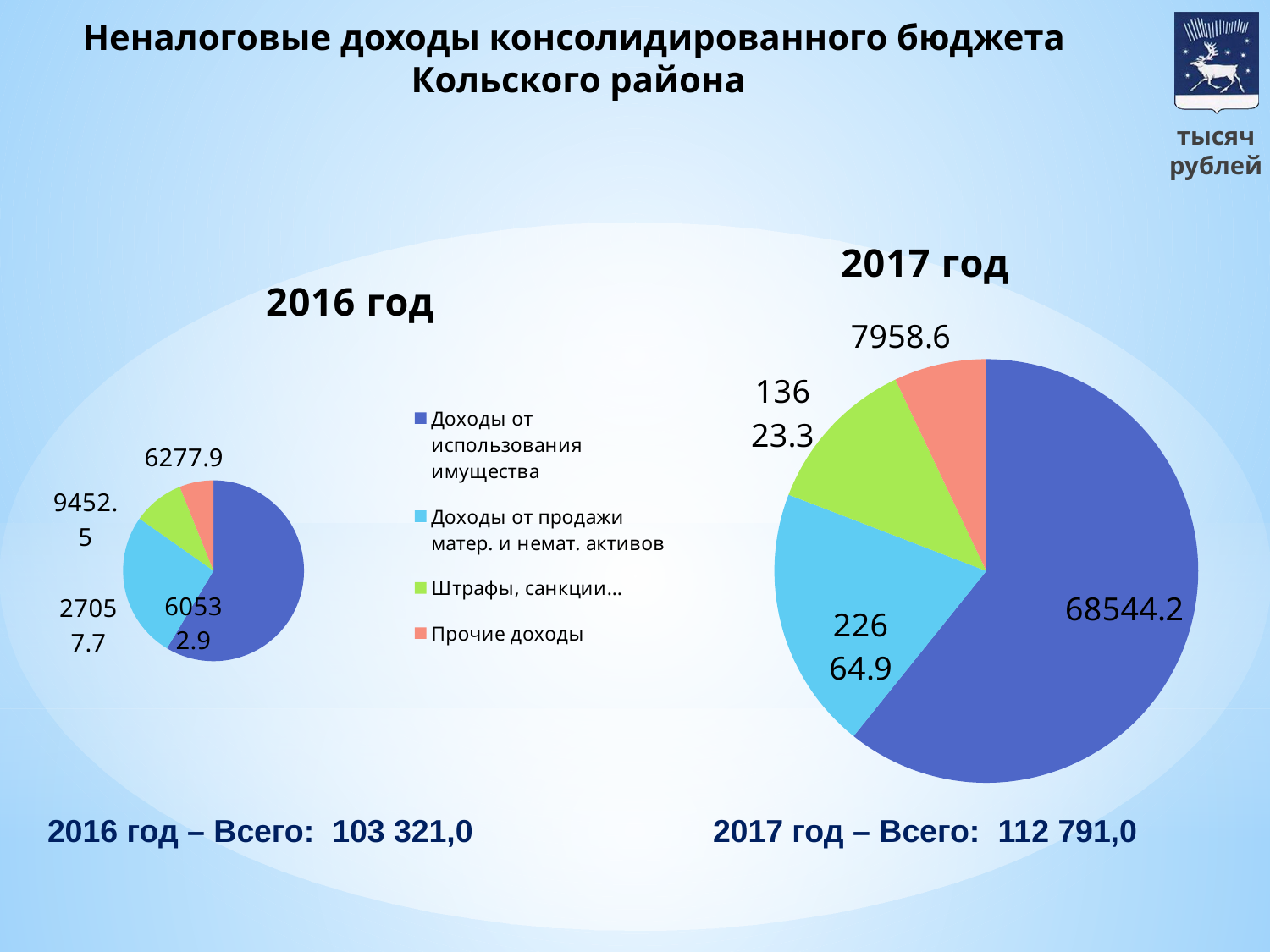
In the 2016 год chart, which category has the smallest slice? Прочие доходы In the 2017 год chart, what is the value for Штрафы, санкции…? 13623.3 In the 2016 год chart, what is the value for Прочие доходы? 6277.9 How many entries does the legend list? 4 What type of charts are shown on the slide? Pie charts What colour represents Штрафы, санкции… in the pie charts? Green In the 2016 год chart, what is the value for Доходы от продажи матер. и немат. активов? 27057.7 How many slices does the 2017 год pie chart have? 4 Which is larger: Прочие доходы in the 2017 год chart or Прочие доходы in the 2016 год chart? 2017 год In the 2017 год chart, what is the value for Доходы от использования имущества? 68544.2 In the 2017 год chart, which category has the largest slice? Доходы от использования имущества What is the difference between the Доходы от использования имущества value in the 2017 год chart and in the 2016 год chart? 8011.3